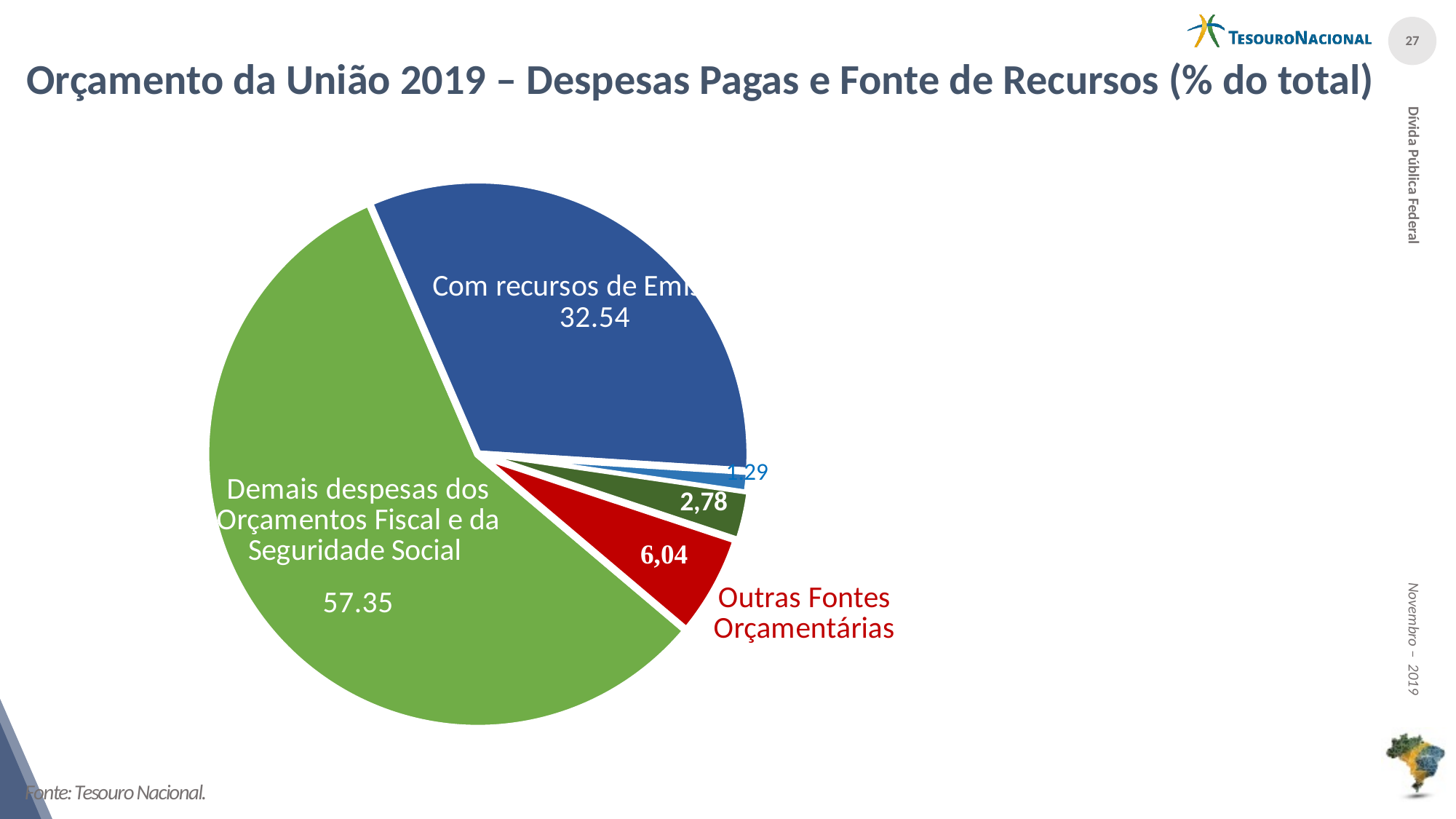
What colour is the 'Outras Fontes Orçamentárias' slice? Red What kind of chart is shown on the slide? Pie chart What is the smallest value shown on the pie chart? 1.29 How many slices does the pie chart have? 5 Which is larger: 'Demais despesas dos Orçamentos Fiscal e da Seguridade Social' or 'Outras Fontes Orçamentárias'? Demais despesas dos Orçamentos Fiscal e da Seguridade Social What value is shown for the slice 'Demais despesas dos Orçamentos Fiscal e da Seguridade Social'? 57.35 Which slice of the pie chart is the largest? Demais despesas dos Orçamentos Fiscal e da Seguridade Social What is the difference between the value of the green 'Demais despesas' slice (57.35) and the large blue slice (32.54)? 24.81 What value is shown on the large blue slice of the pie chart? 32.54 What is the difference between the red slice value (6,04) and the dark green slice value (2,78)? 3,26 What is the title of the chart on the slide? Orçamento da União 2019 – Despesas Pagas e Fonte de Recursos (% do total) What value is shown for the slice 'Outras Fontes Orçamentárias'? 6,04